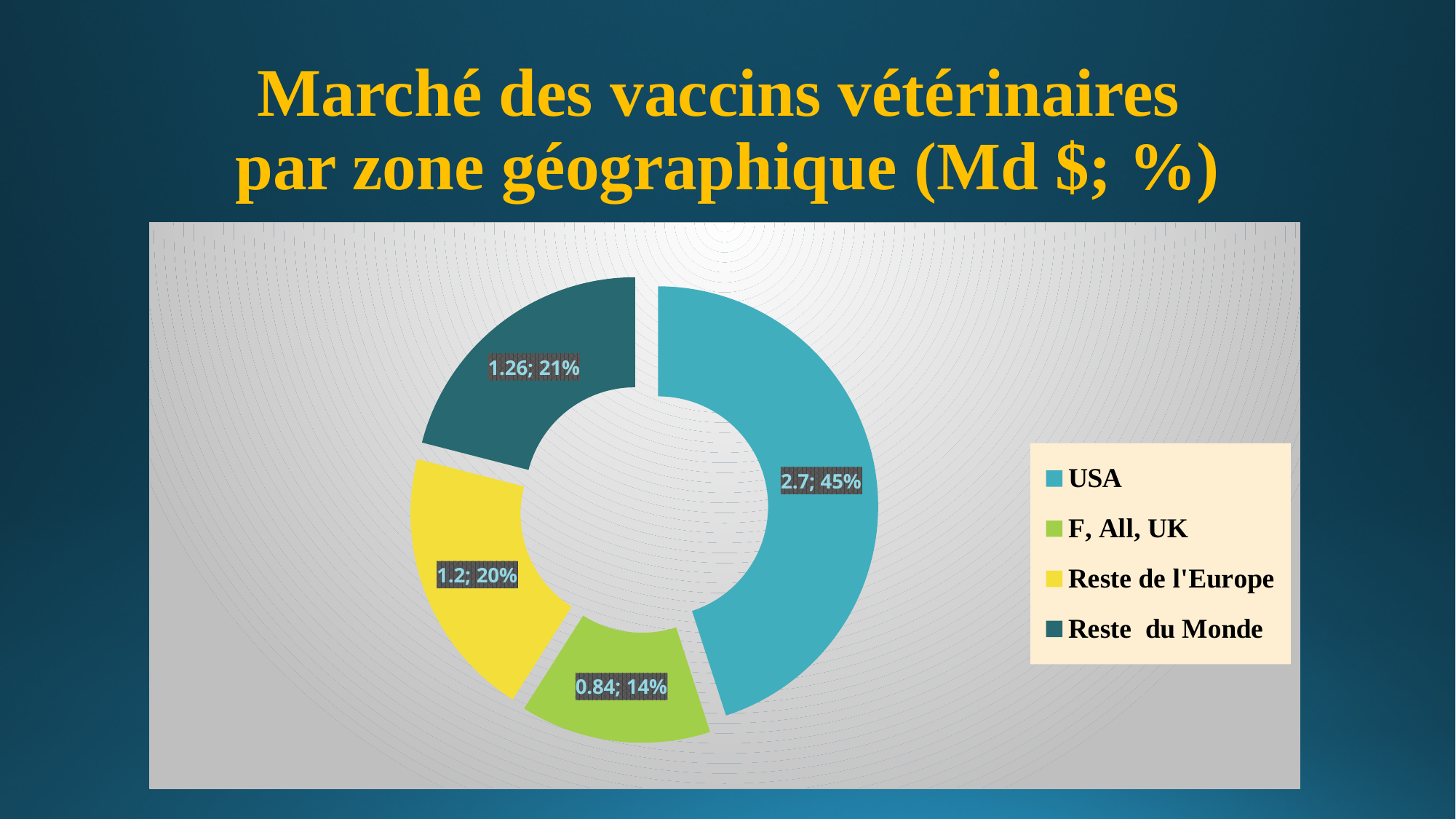
What is the value for USA in the chart? 2.7; 45% What type of chart is shown on the slide? Doughnut (pie) chart How many zones are shown in the chart? 4 What is the value for Reste de l'Europe in the chart? 1.2; 20% Which zone has the largest share of the market? USA What is the value for F, All, UK in the chart? 0.84; 14% What percentage share does Reste de l'Europe hold? 20% What is the value for Reste du Monde in the chart? 1.26; 21% What percentage share does USA hold? 45% Which is larger in Md $: Reste de l'Europe or F, All, UK? Reste de l'Europe What is the difference in Md $ between USA and F, All, UK? 1.86 Which zone has the smallest share of the market? F, All, UK